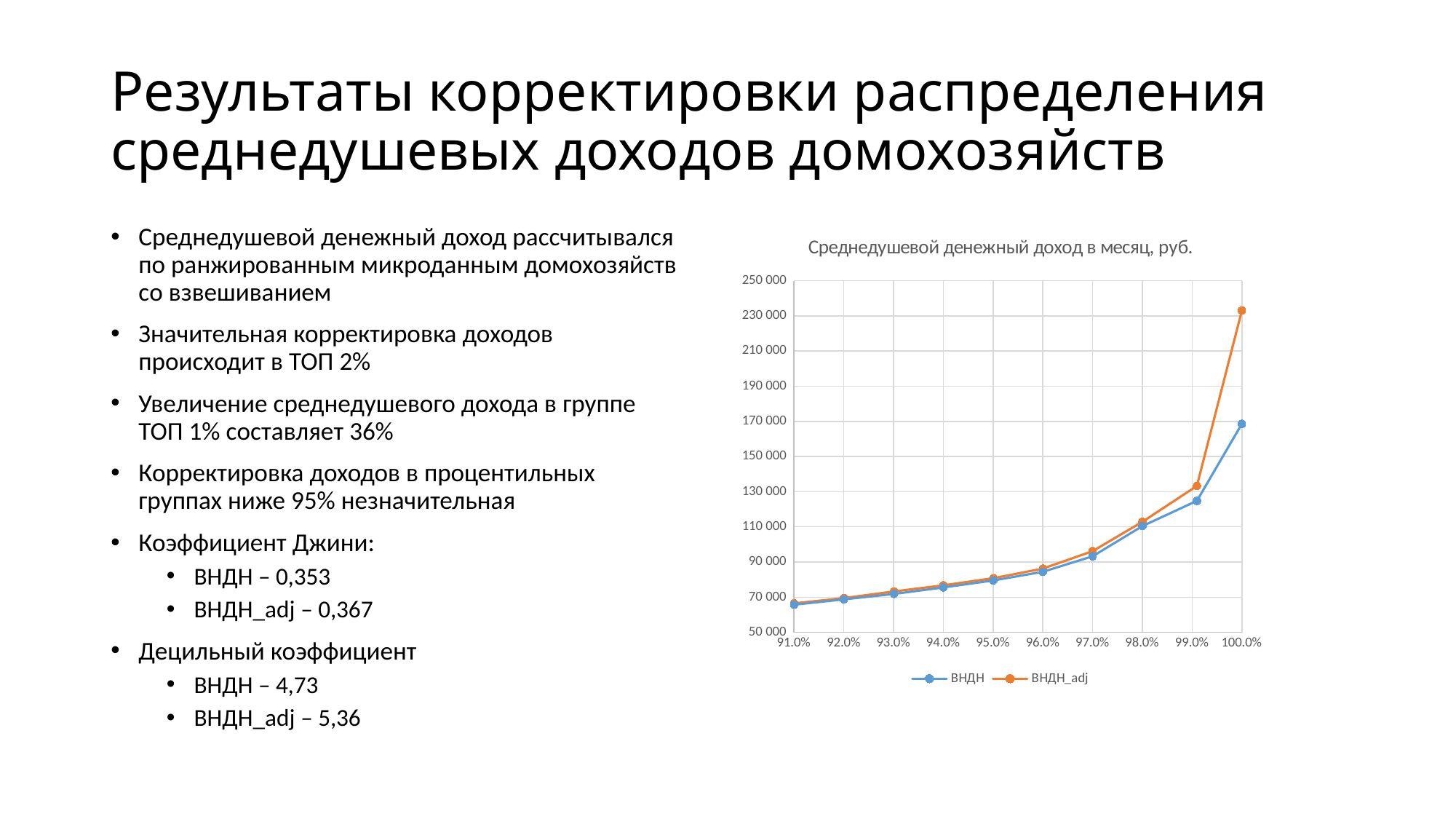
How many points are plotted along the x axis for each series? 10 Is the value of ВНДН at 95.0% greater or less than 90 000? less At which x-axis category is the ВНДН series at its lowest value? 91.0% Do the values of the ВНДН_adj series rise or fall as the x axis goes from 91.0% to 100.0%? rise At which x-axis category does the ВНДН_adj series reach its highest value? 100.0% What kind of chart is shown on the slide? line chart Is the value of ВНДН_adj at 100.0% greater or less than 210 000? greater At 100.0%, which series has the higher value, ВНДН or ВНДН_adj? ВНДН_adj Is the value of ВНДН at 100.0% greater or less than 190 000? less How many series does the chart legend list? 2 What are the names of the two series in the chart legend? ВНДН and ВНДН_adj What is the title of the chart? Среднедушевой денежный доход в месяц, руб.